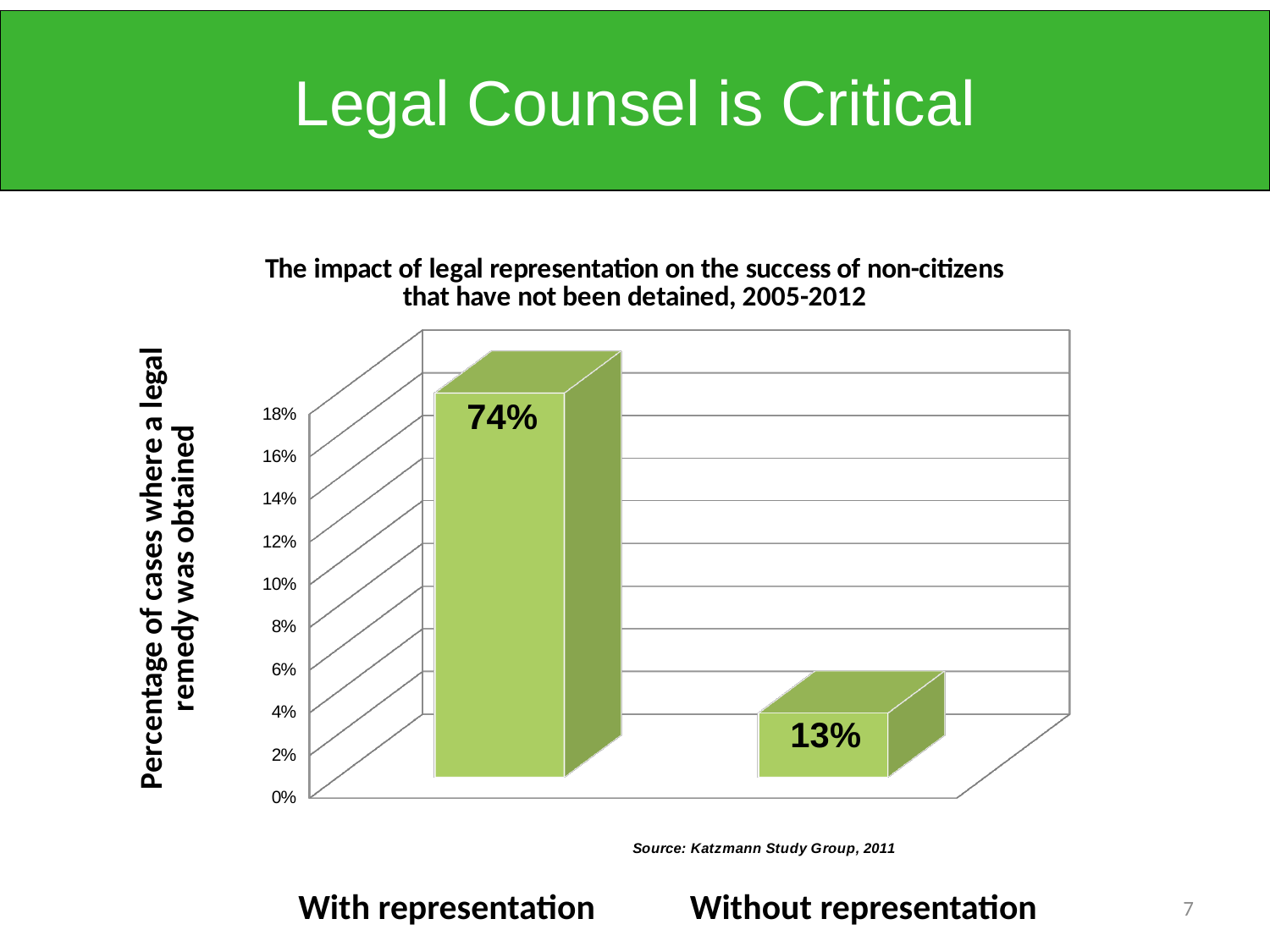
How many categories are shown in the chart? 2 What is the difference between the values for With representation and Without representation? 61% What kind of chart is shown on the slide? Bar chart Which is larger, the value for With representation or the value for Without representation? With representation What is the title of the chart? The impact of legal representation on the success of non-citizens that have not been detained, 2005-2012 What is the value for With representation? 74% What is the source cited below the chart? Katzmann Study Group, 2011 Which category has the highest value? With representation What is the value for Without representation? 13% Which category has the lowest value? Without representation